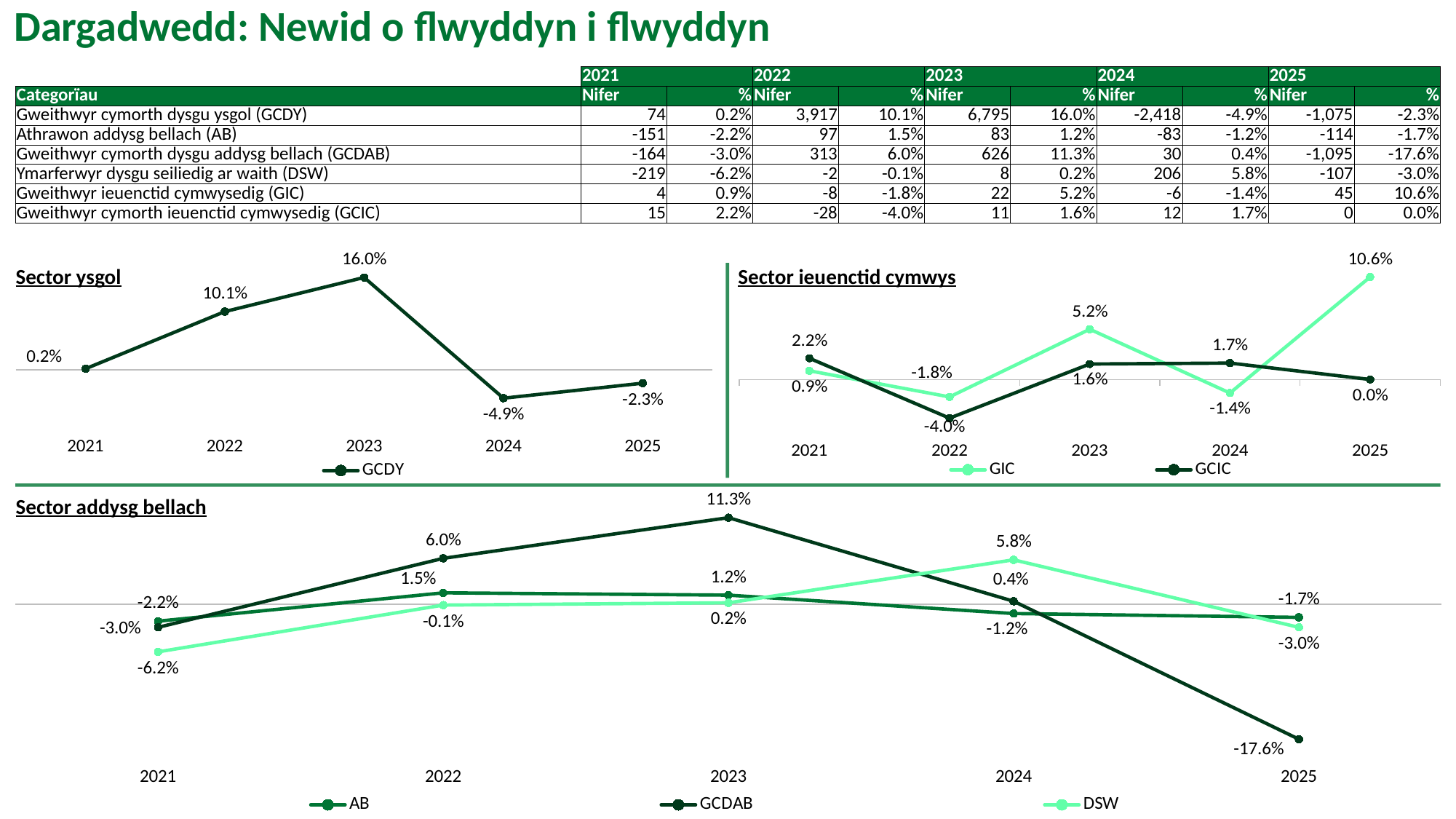
In the 'Sector ysgol' chart, how many years are plotted on the x axis? 5 In the 'Sector ieuenctid cymwys' chart, which is larger in 2023: GIC or GCIC? GIC In the 'Sector ieuenctid cymwys' chart, what is the GIC value for 2025? 10.6% In the 'Sector addysg bellach' chart, what is the difference between the GCDAB values for 2023 and 2024? 10.9% In the 'Sector ieuenctid cymwys' chart, how many series does the legend list? 2 In the 'Sector ieuenctid cymwys' chart, what is the GCIC value for 2022? -4.0% In the 'Sector addysg bellach' chart, what is the GCDAB value for 2025? -17.6% In the 'Sector addysg bellach' chart, which series has the highest value in 2024? DSW In the 'Sector ysgol' chart, which year has the lowest GCDY value? 2024 In the 'Sector ysgol' chart, what is the GCDY value for 2023? 16.0% What type of chart is the 'Sector addysg bellach' chart? Line chart In the 'Sector ysgol' chart, what is the difference between the GCDY values for 2023 and 2022? 5.9%